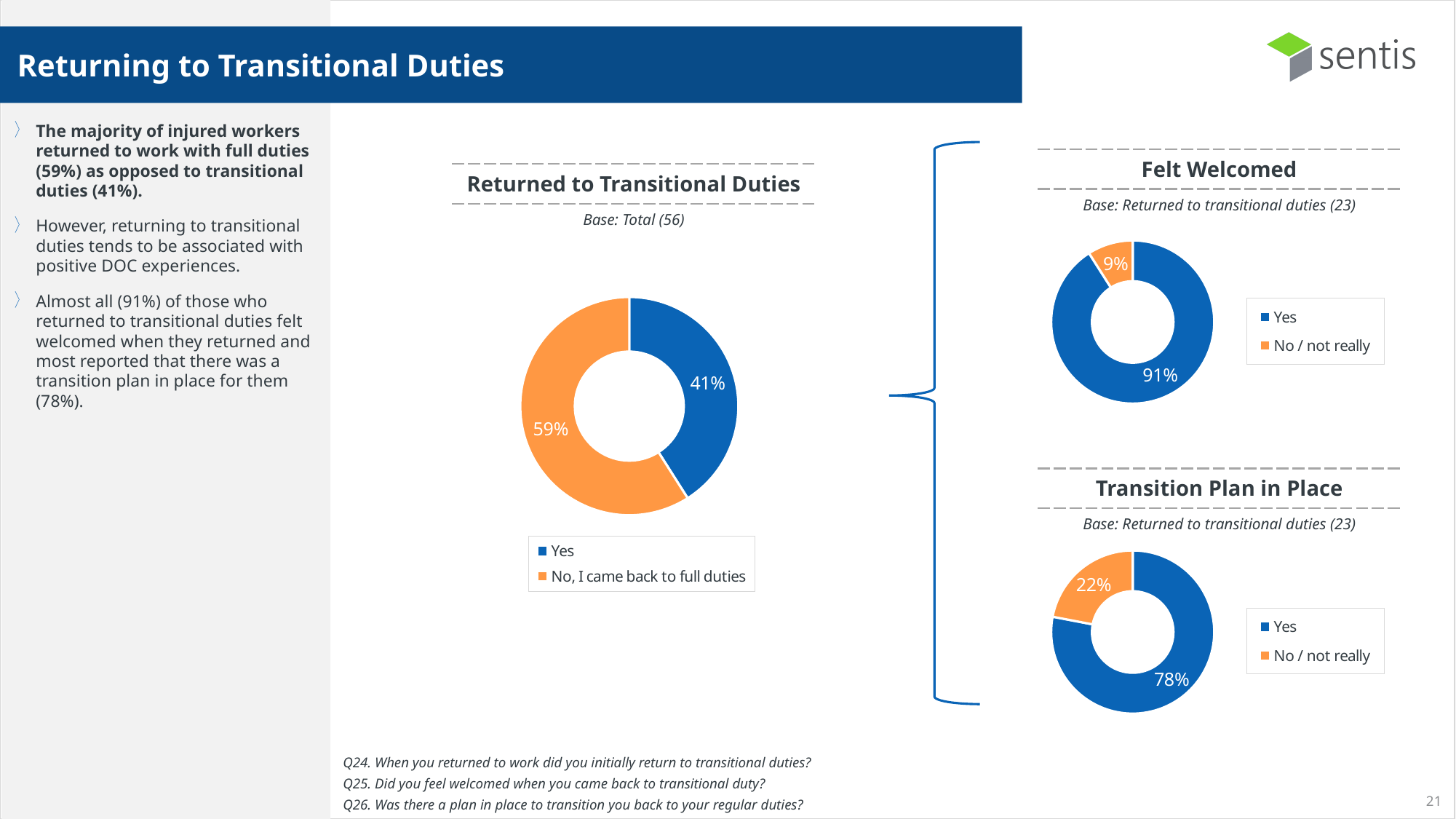
In the 'Felt Welcomed' chart, which category has the smallest share? No / not really What type of chart is the 'Felt Welcomed' chart? Doughnut (pie) chart In the 'Returned to Transitional Duties' chart, which category has the larger share? No, I came back to full duties In the 'Transition Plan in Place' chart, what percentage answered Yes? 78% In the 'Returned to Transitional Duties' chart, what percentage is shown for 'No, I came back to full duties'? 59% What is the base stated for the 'Returned to Transitional Duties' chart? Total (56) In the 'Felt Welcomed' chart, what percentage answered Yes? 91% How many entries does the legend of the 'Transition Plan in Place' chart list? 2 In the 'Felt Welcomed' chart, what percentage answered 'No / not really'? 9% In the 'Transition Plan in Place' chart, what is the difference between the Yes and 'No / not really' percentages? 56% In the 'Transition Plan in Place' chart, what percentage answered 'No / not really'? 22% In the 'Returned to Transitional Duties' chart, what percentage answered Yes? 41%